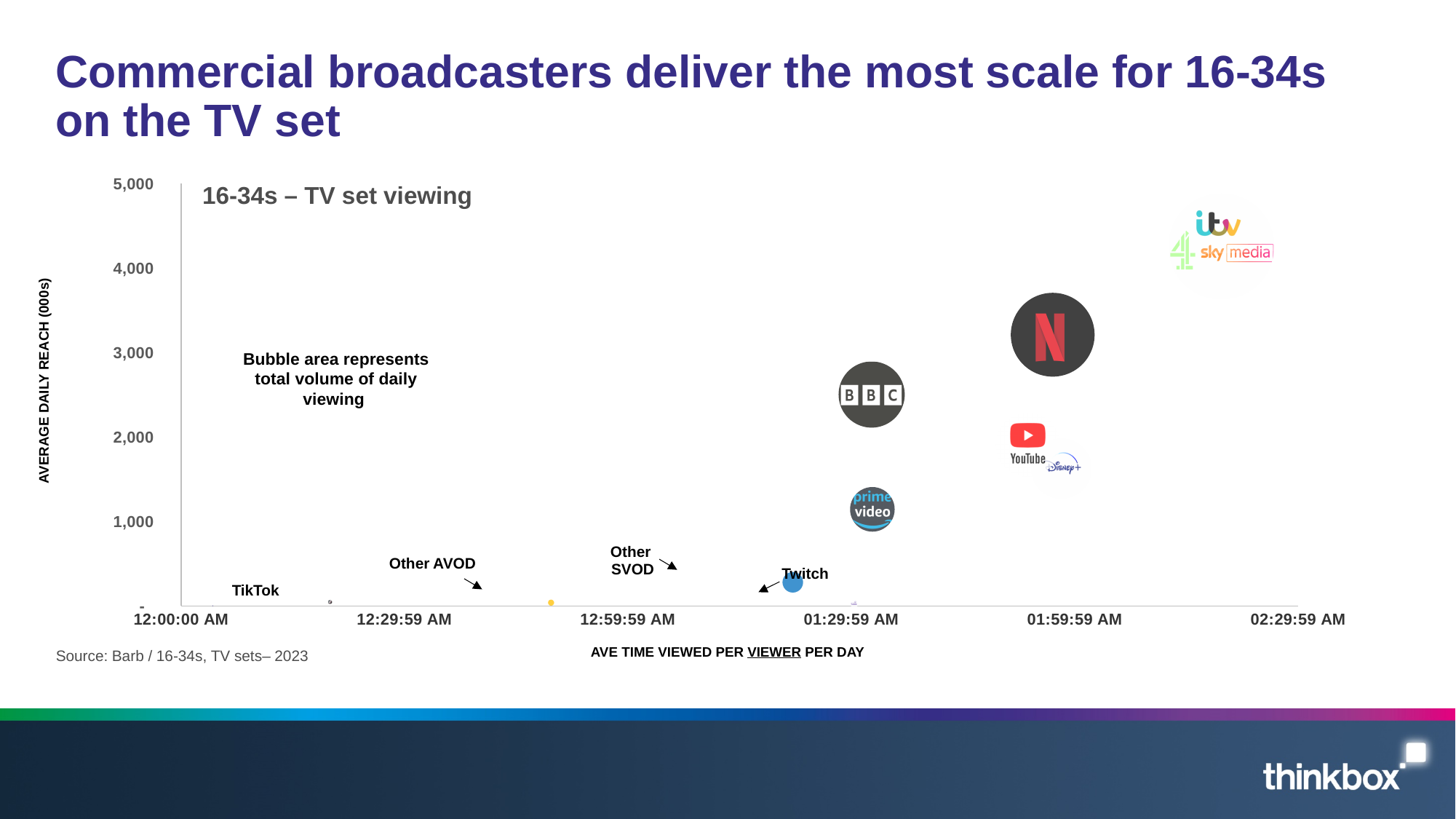
What kind of chart is shown on the slide? Bubble chart Which bubble has the highest average daily reach? Commercial broadcasters (ITV, Channel 4, Sky Media) What does the bubble area represent in the chart? Total volume of daily viewing Is the average daily reach for Netflix greater or less than 3,000? greater Is the average daily reach for YouTube greater or less than 3,000? less What is the title of the chart? 16-34s – TV set viewing Is the average daily reach for BBC greater or less than 3,000? less Which has the higher average daily reach, Netflix or BBC? Netflix Which has the higher average daily reach, Prime Video or Twitch? Prime Video